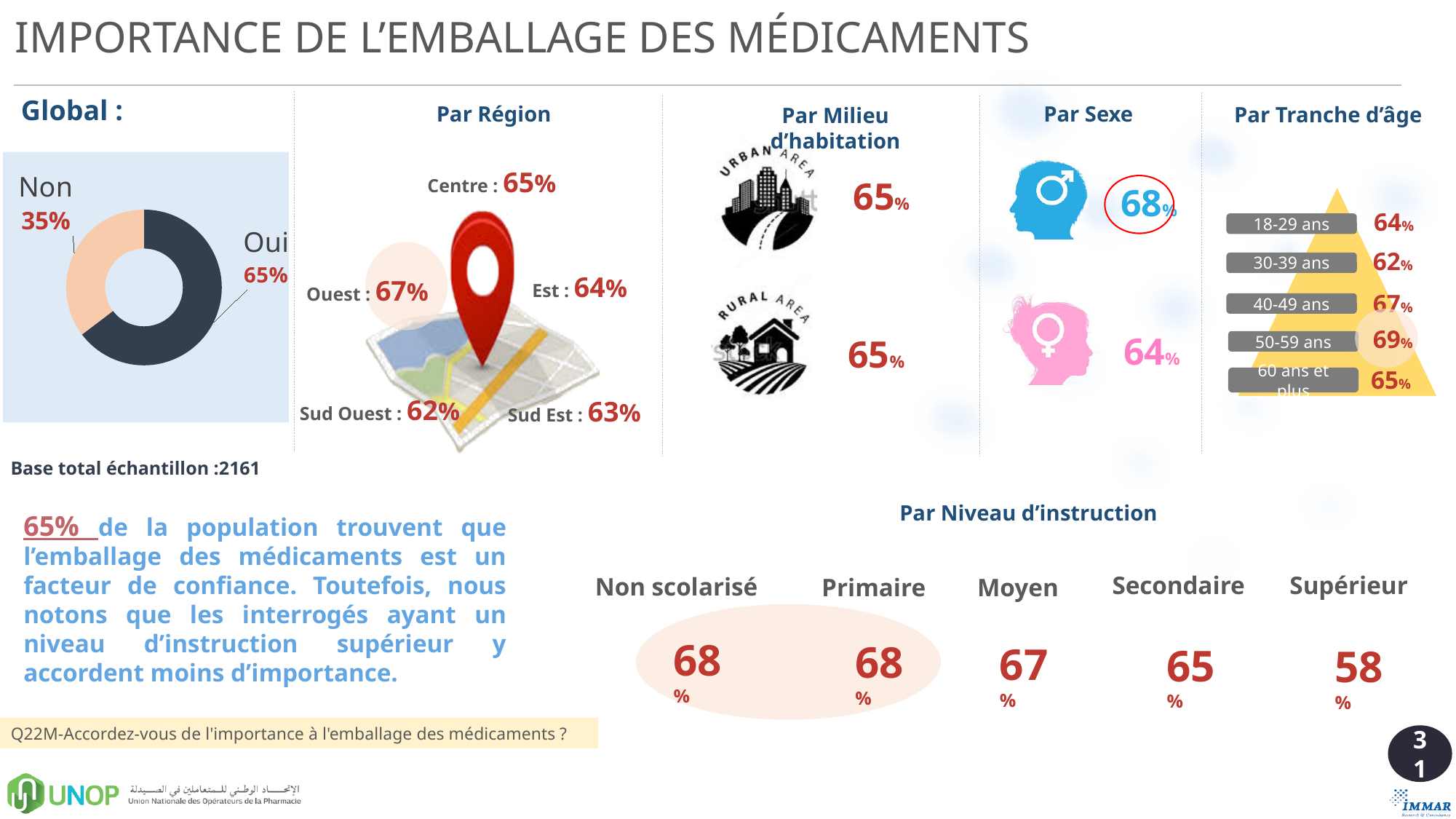
How many categories does the 'Global' donut chart show? 2 In the 'Par Région' section, which region has the lowest value? Sud Ouest In the 'Par Niveau d'instruction' section, which level has the lowest value? Supérieur In the 'Par Région' section, which region has the highest value? Ouest In the 'Global' donut chart, what percentage answered 'Non'? 35% In the 'Par Sexe' section, what is the difference between the male and female values? 4% In the 'Global' donut chart, what is the difference between the 'Oui' and 'Non' shares? 30% In the 'Global' donut chart, which category has the larger share, 'Oui' or 'Non'? Oui In the 'Par Tranche d'âge' pyramid, what is the value for '50-59 ans'? 69% In the 'Global' donut chart, what is the total of the 'Oui' and 'Non' shares? 100% In the 'Global' donut chart, what percentage answered 'Oui'? 65% What type of chart is used in the 'Global' section? Donut (pie) chart